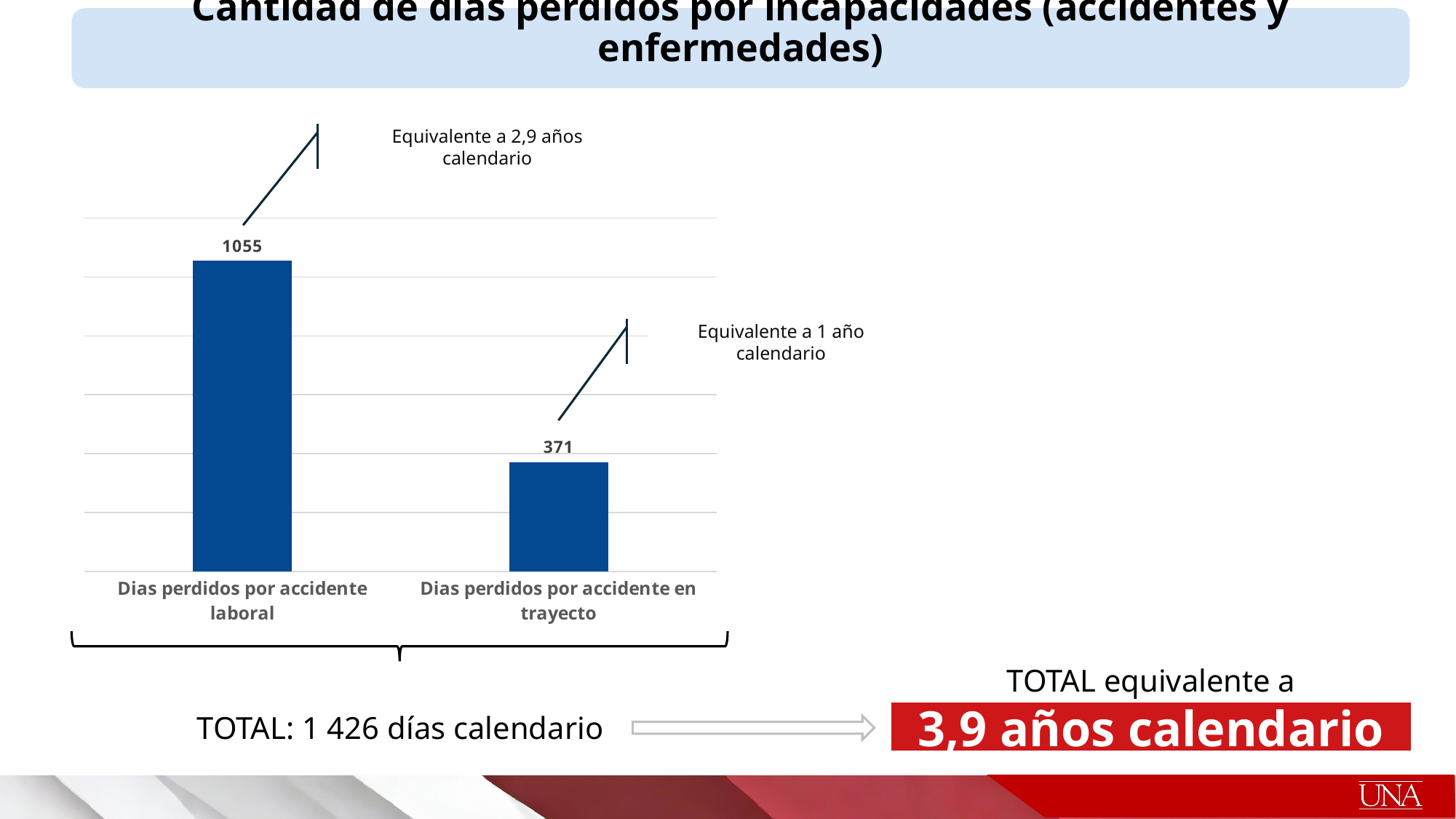
Which is larger: the value for Dias perdidos por accidente laboral or for Dias perdidos por accidente en trayecto? Dias perdidos por accidente laboral How many categories are shown in the chart? 2 What is the difference between the values for Dias perdidos por accidente laboral and Dias perdidos por accidente en trayecto? 684 What is the total of the two bar values shown in the chart? 1426 According to the slide, how many calendar years is the total of 1 426 days equivalent to? 3,9 años calendario According to the annotation, how many calendar years are the days lost due to accidente laboral equivalent to? 2,9 años calendario What is the value for Dias perdidos por accidente laboral? 1055 What is the value for Dias perdidos por accidente en trayecto? 371 What kind of chart is shown on the slide? Bar chart Which category has the lowest value? Dias perdidos por accidente en trayecto Which category has the highest value? Dias perdidos por accidente laboral